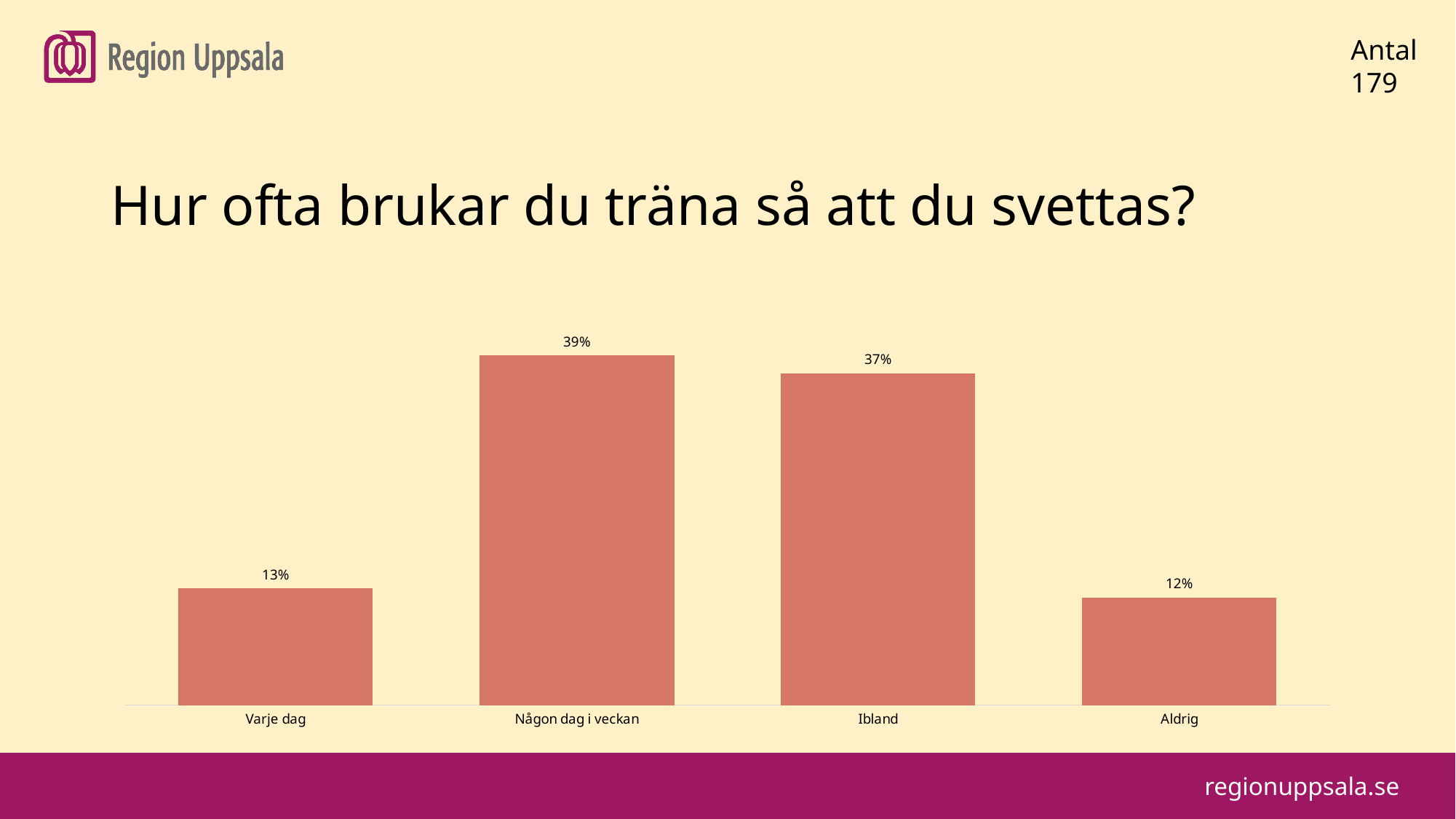
What is the difference between the values for "Någon dag i veckan" and "Ibland"? 2% What is the value for "Aldrig"? 12% What is the value for "Varje dag"? 13% What is the difference between the values for "Varje dag" and "Aldrig"? 1% Which category has the highest value? Någon dag i veckan Which category has the lowest value? Aldrig How many categories are shown in the chart? 4 What is the value for "Någon dag i veckan"? 39% Which is larger, the value for "Ibland" or the value for "Varje dag"? Ibland What is the title of the slide above the chart? Hur ofta brukar du träna så att du svettas? What is the value for "Ibland"? 37% What kind of chart is shown on the slide? Bar chart